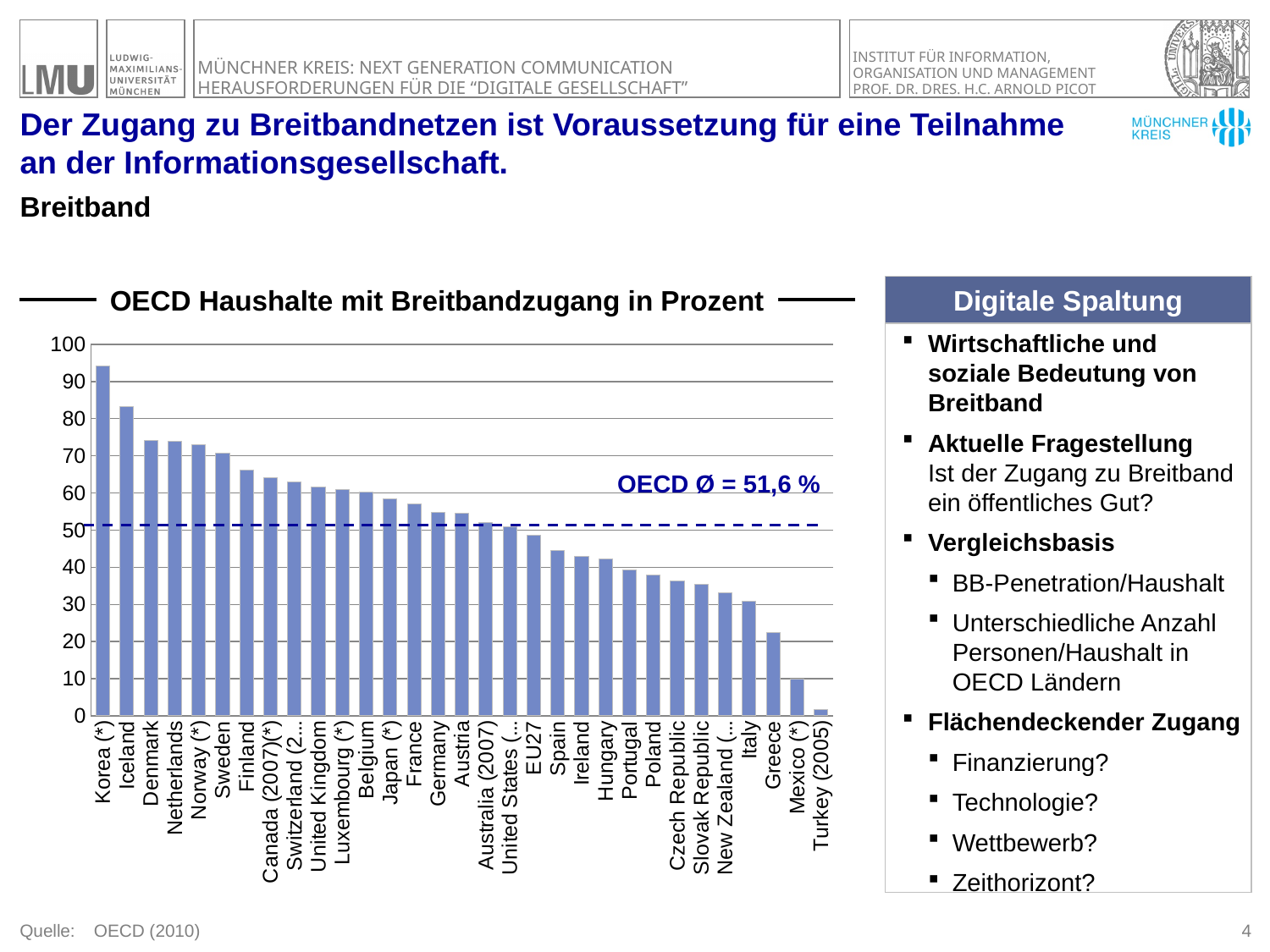
How many countries or regions are shown as bars in the chart? 31 Which country has the lowest share of households with broadband access in the chart? Turkey (2005) What kind of chart is shown on the slide? bar chart Is the value for Germany greater or less than 50? greater Which country has the highest share of households with broadband access in the chart? Korea (*) Do the bar values rise or fall from left to right along the x axis? fall Is the value for Greece greater or less than 30? less Which has a higher value, Iceland or Denmark? Iceland What is the title of the chart? OECD Haushalte mit Breitbandzugang in Prozent Is the value for Spain greater or less than 50? less What OECD average value is printed on the chart? 51,6 %